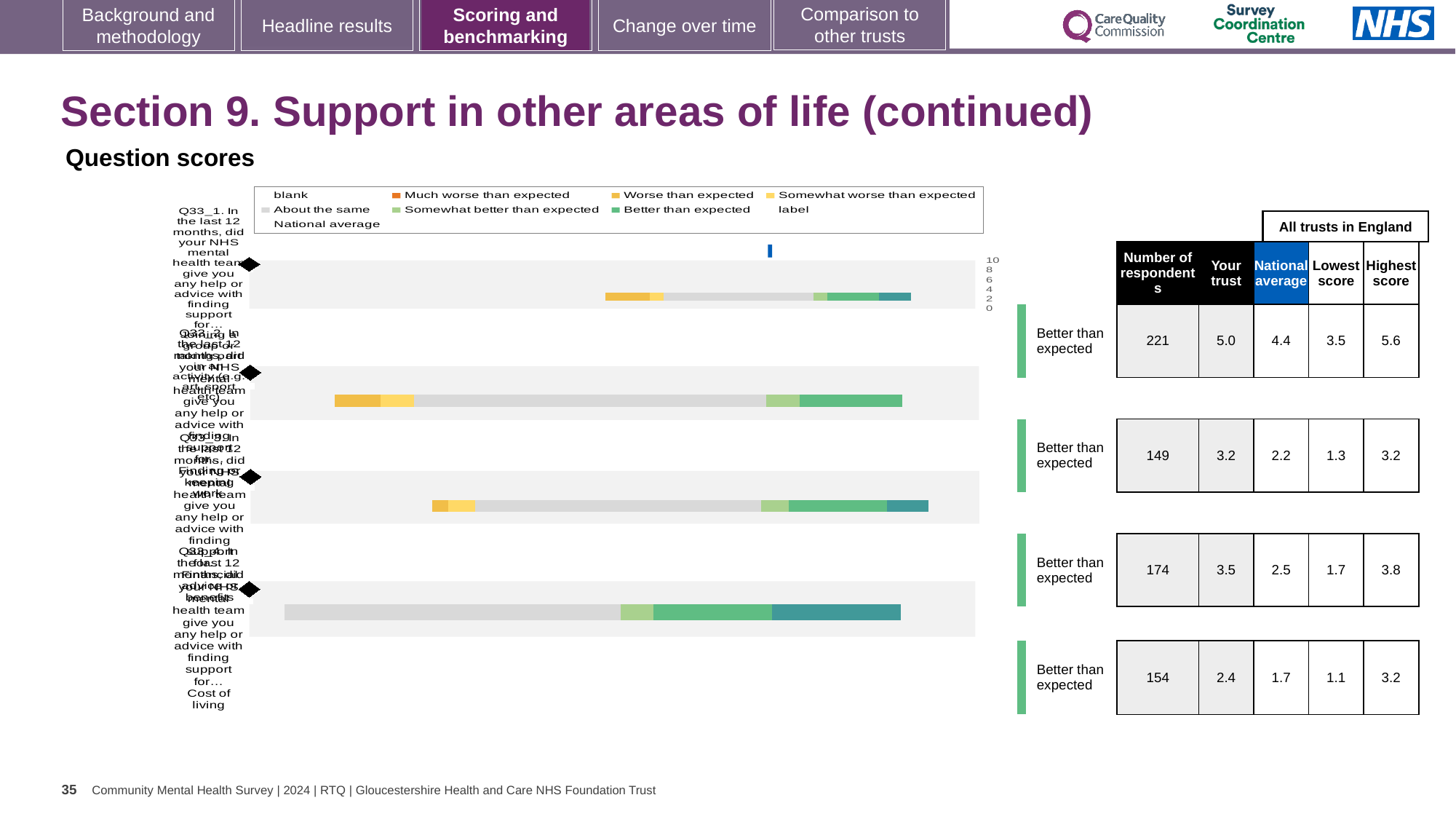
What kind of chart is shown under 'Question scores'? Bar chart How many question bars are plotted in the 'Question scores' chart? 4 What benchmark rating is shown beside every bar in the 'Question scores' chart? Better than expected In the table next to the 'Question scores' chart, which row has the highest 'Your trust' score? The top (first) question, 5.0 How many entries does the legend of the 'Question scores' chart list? 9 In the table next to the 'Question scores' chart, what is the 'Your trust' score for the top question? 5.0 In the table next to the 'Question scores' chart, how many respondents are listed for the top question? 221 For the top question in the table next to the 'Question scores' chart, what is the difference between the 'Your trust' score and the 'National average'? 0.6 For the bottom question (Cost of living) in the table, which is larger: the 'Your trust' score or the 'National average'? Your trust (2.4) In the table next to the 'Question scores' chart, which row has the lowest number of respondents? The second question, 149 In the table next to the 'Question scores' chart, what is the 'Lowest score' for the third question? 1.7 In the table next to the 'Question scores' chart, what is the 'Highest score' for the bottom question (Cost of living)? 3.2